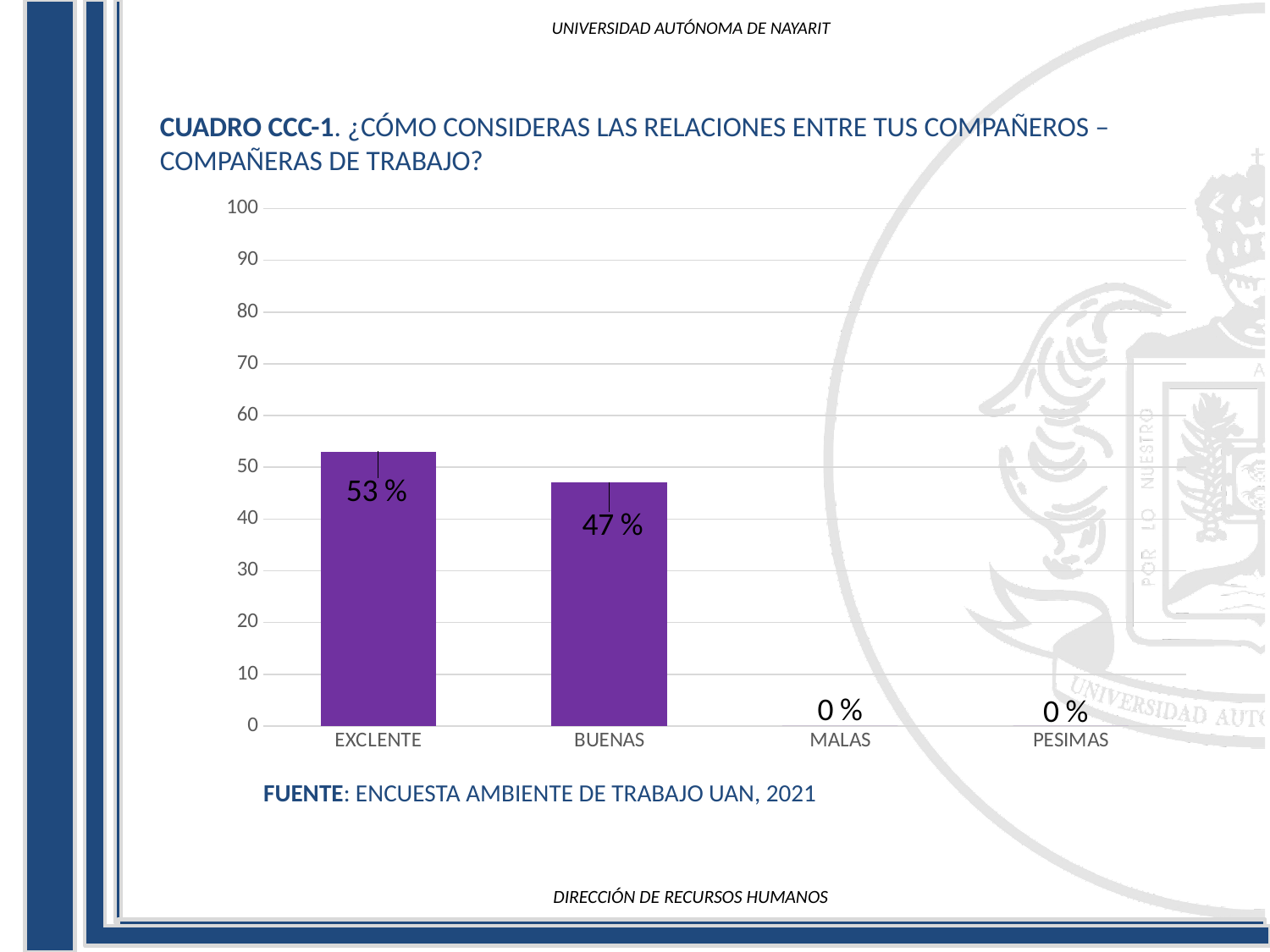
Which category has the highest value? EXCLENTE Do the values rise or fall from left to right along the x axis? fall How many categories are shown on the x axis? 4 Which is larger, the value for EXCLENTE or the value for BUENAS? EXCLENTE What kind of chart is shown on the slide? bar chart What is the value for MALAS? 0 % What is the value for BUENAS? 47 % What is the difference between the values for EXCLENTE and BUENAS? 6 % What source is cited below the chart? ENCUESTA AMBIENTE DE TRABAJO UAN, 2021 What is the value for PESIMAS? 0 % Is the value for BUENAS greater or less than 50? less What is the value for EXCLENTE? 53 %